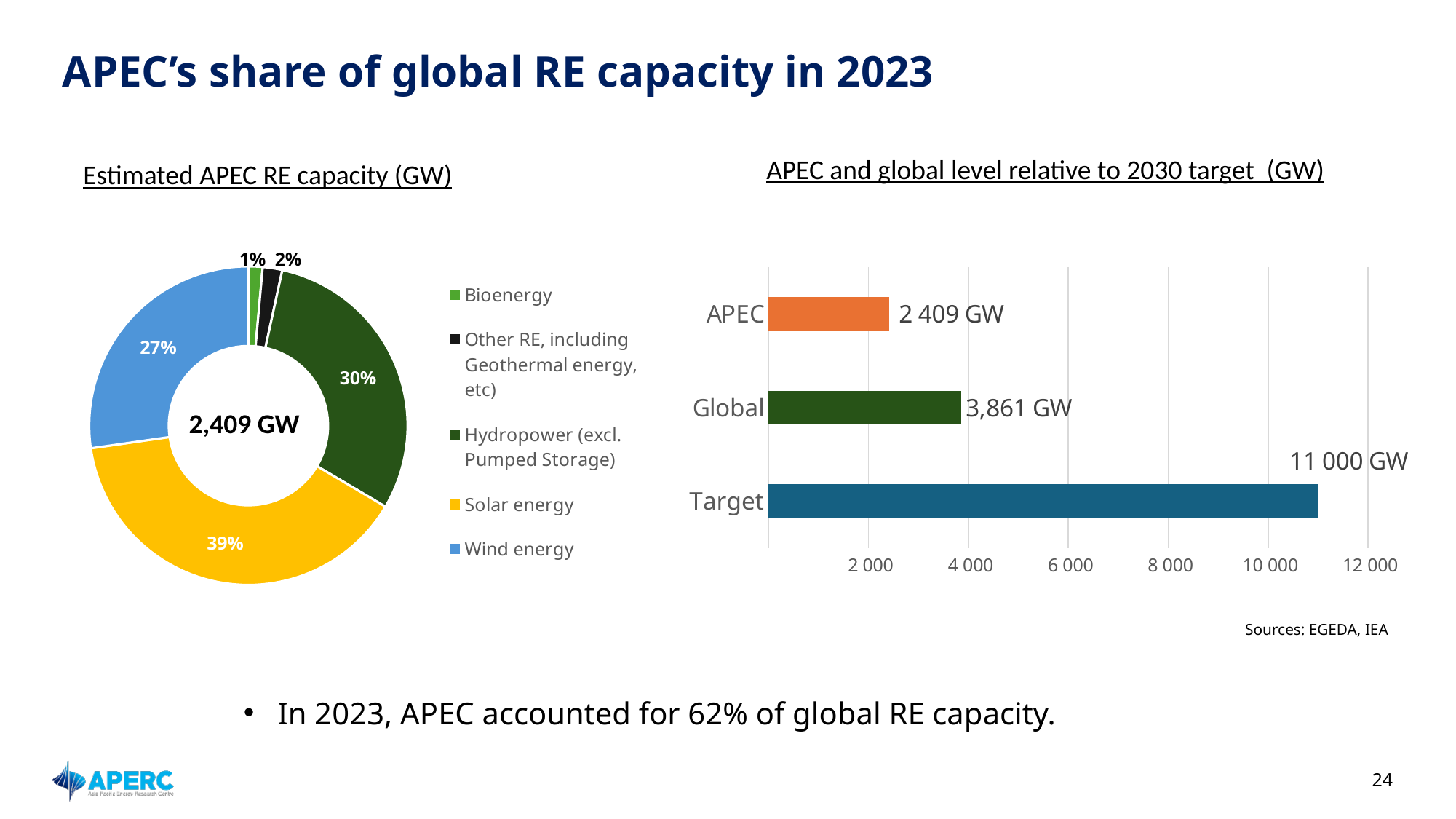
In the 'Estimated APEC RE capacity (GW)' chart, what share does Solar energy have? 39% In the 'Estimated APEC RE capacity (GW)' chart, what share does Hydropower (excl. Pumped Storage) have? 30% What kind of chart is the 'APEC and global level relative to 2030 target (GW)' chart? Bar chart In the 'APEC and global level relative to 2030 target (GW)' chart, which category has the highest value? Target In the 'Estimated APEC RE capacity (GW)' chart, what total value is shown in the centre of the donut? 2,409 GW In the 'Estimated APEC RE capacity (GW)' chart, what share does Wind energy have? 27% What kind of chart is the 'Estimated APEC RE capacity (GW)' chart? Donut (pie) chart In the 'Estimated APEC RE capacity (GW)' chart, which category has the largest share? Solar energy In the 'APEC and global level relative to 2030 target (GW)' chart, what is the value for Target? 11 000 GW In the 'APEC and global level relative to 2030 target (GW)' chart, what is the value for Global? 3,861 GW In the 'Estimated APEC RE capacity (GW)' chart, how many categories does the legend list? 5 In the 'Estimated APEC RE capacity (GW)' chart, which category has the smallest share? Bioenergy